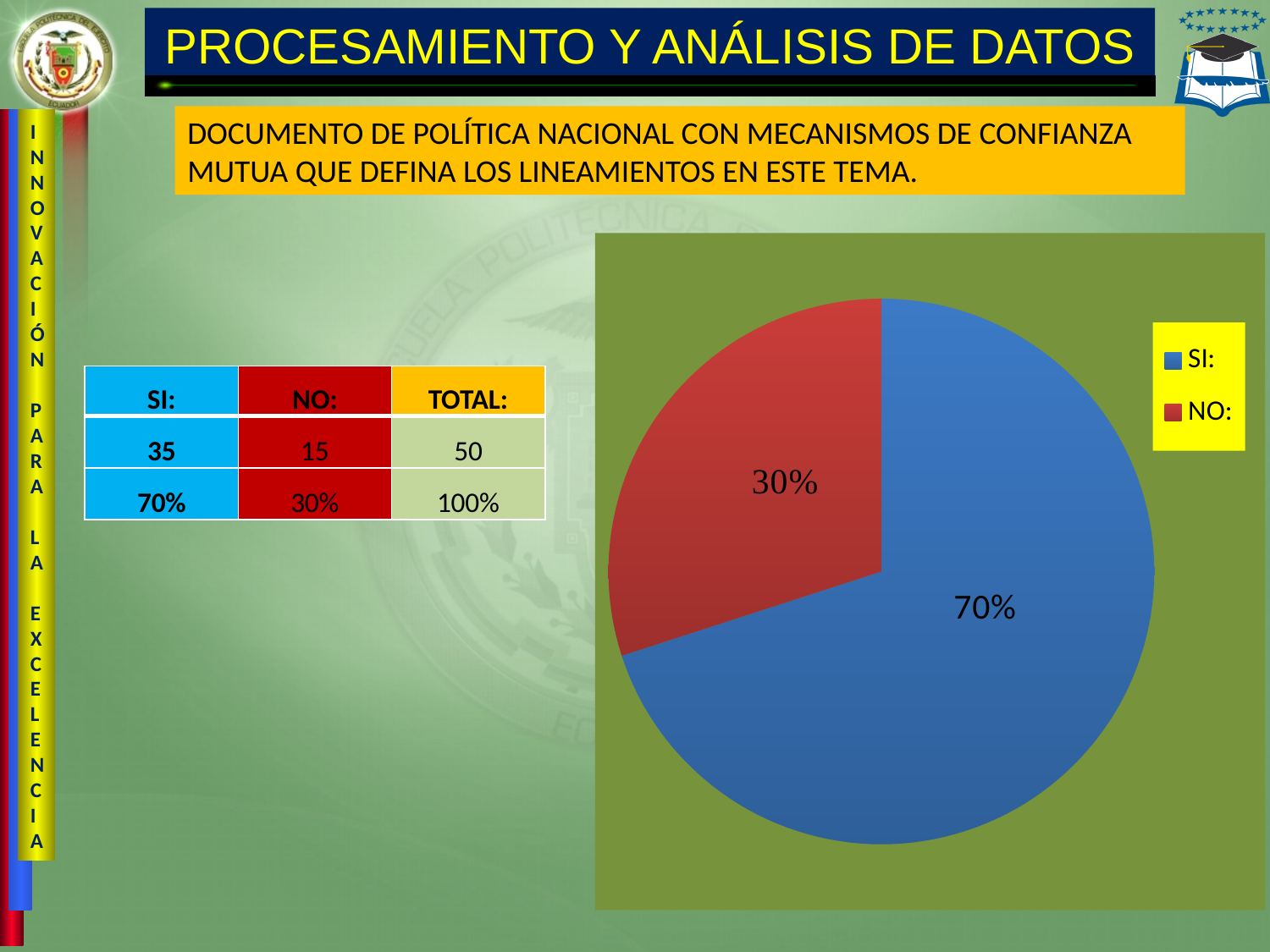
Which is larger in the pie chart, SI: or NO:? SI: What colour is the SI: slice in the pie chart? blue What kind of chart is shown on the slide? pie chart What share of the pie does the SI: slice represent? 70% How many entries does the legend of the pie chart list? 2 What colour is the NO: slice in the pie chart? red What is the difference in percentage points between the SI: and NO: slices? 40% Which slice of the pie chart is the largest? SI: How many slices does the pie chart have? 2 What share of the pie does the NO: slice represent? 30% Which slice of the pie chart is the smallest? NO: